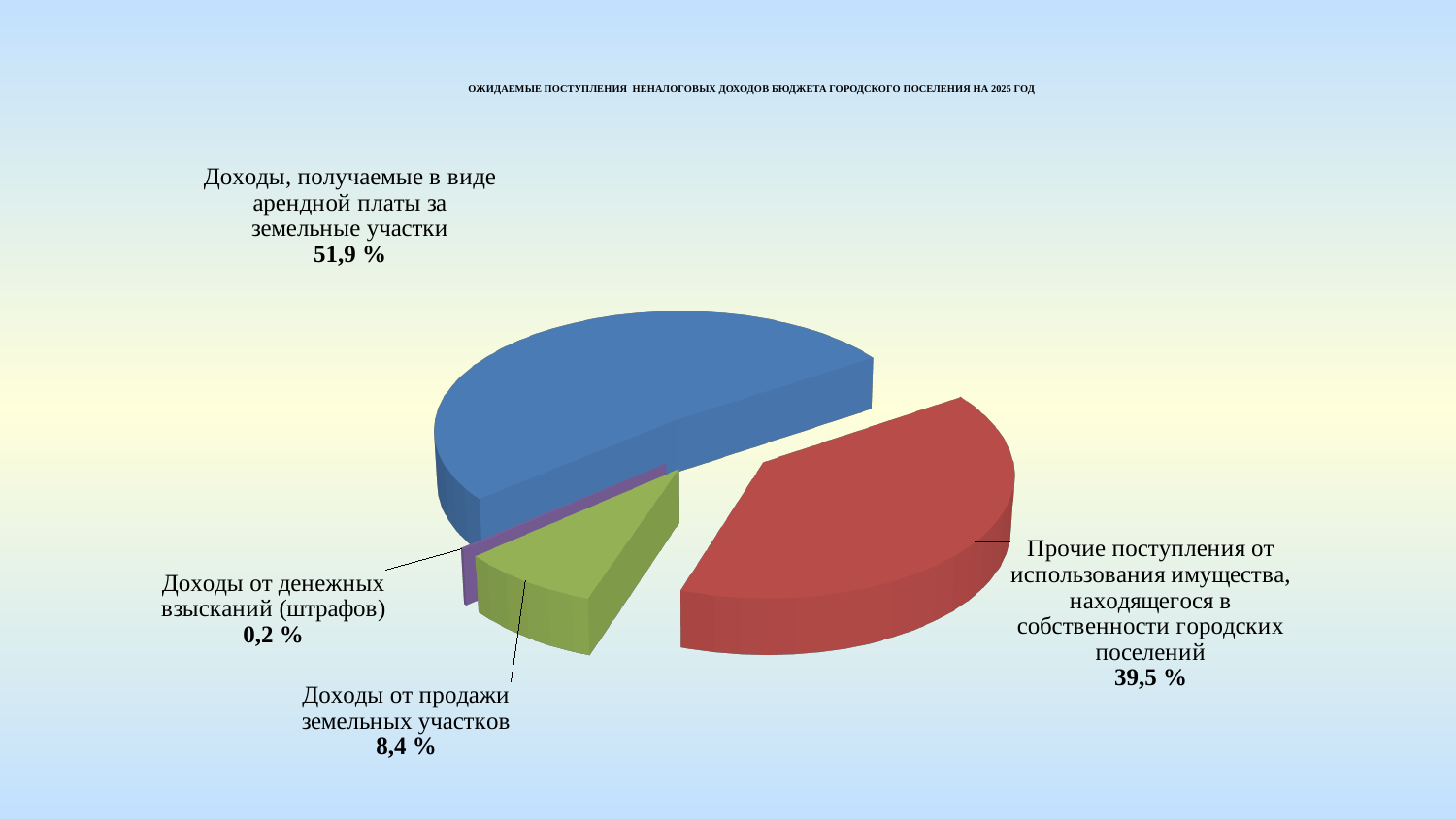
What share is shown for "Доходы от продажи земельных участков"? 8,4 % Which category has the largest share of the pie? Доходы, получаемые в виде арендной платы за земельные участки What is the difference in percentage points between the share for rental income from land plots (51,9 %) and other income from use of property (39,5 %)? 12,4 What year does the chart title refer to? 2025 What share is shown for "Доходы от денежных взысканий (штрафов)"? 0,2 % What share is shown for "Прочие поступления от использования имущества, находящегося в собственности городских поселений"? 39,5 % What type of chart is shown on the slide? Pie chart What colour is the slice for "Прочие поступления от использования имущества, находящегося в собственности городских поселений"? Red Which is larger: the share for "Доходы от продажи земельных участков" or the share for "Доходы от денежных взысканий (штрафов)"? Доходы от продажи земельных участков Which category has the smallest share of the pie? Доходы от денежных взысканий (штрафов) What share of the pie is labelled for "Доходы, получаемые в виде арендной платы за земельные участки"? 51,9 % How many slices does the pie chart have? 4